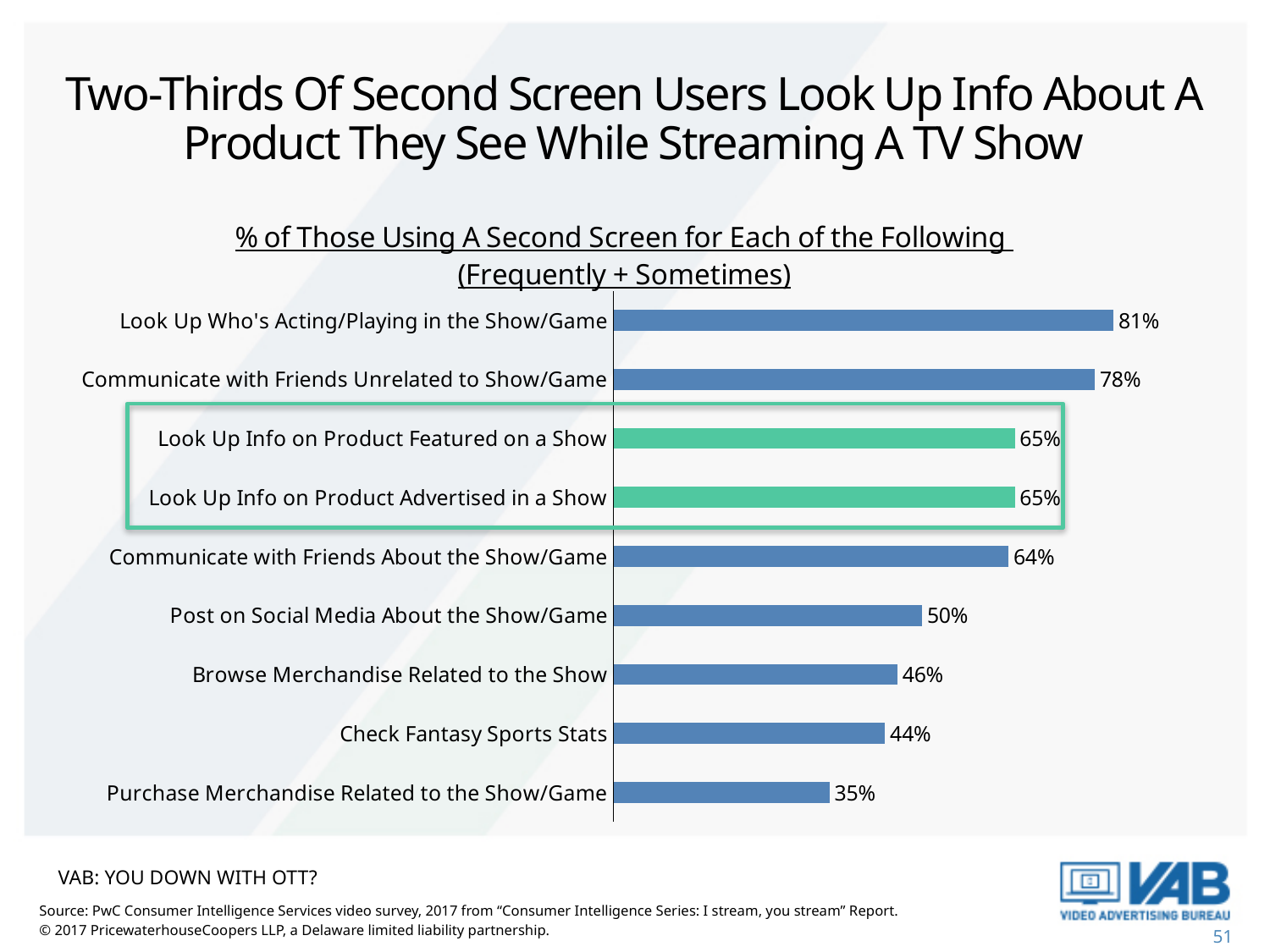
What percentage of second screen users look up who's acting/playing in the show/game? 81% Which activity has the highest percentage? Look Up Who's Acting/Playing in the Show/Game What is the value for 'Post on Social Media About the Show/Game'? 50% How many activities are shown in the chart? 9 What is the difference between 'Browse Merchandise Related to the Show' and 'Purchase Merchandise Related to the Show/Game'? 11% What kind of chart is shown on the slide? Bar chart Which is larger: 'Post on Social Media About the Show/Game' or 'Browse Merchandise Related to the Show'? Post on Social Media About the Show/Game What is the difference between 'Look Up Who's Acting/Playing in the Show/Game' and 'Communicate with Friends Unrelated to Show/Game'? 3% Which two bars are highlighted in green? Look Up Info on Product Featured on a Show and Look Up Info on Product Advertised in a Show What is the value for 'Purchase Merchandise Related to the Show/Game'? 35% What is the value for 'Check Fantasy Sports Stats'? 44% Which activity has the lowest percentage? Purchase Merchandise Related to the Show/Game